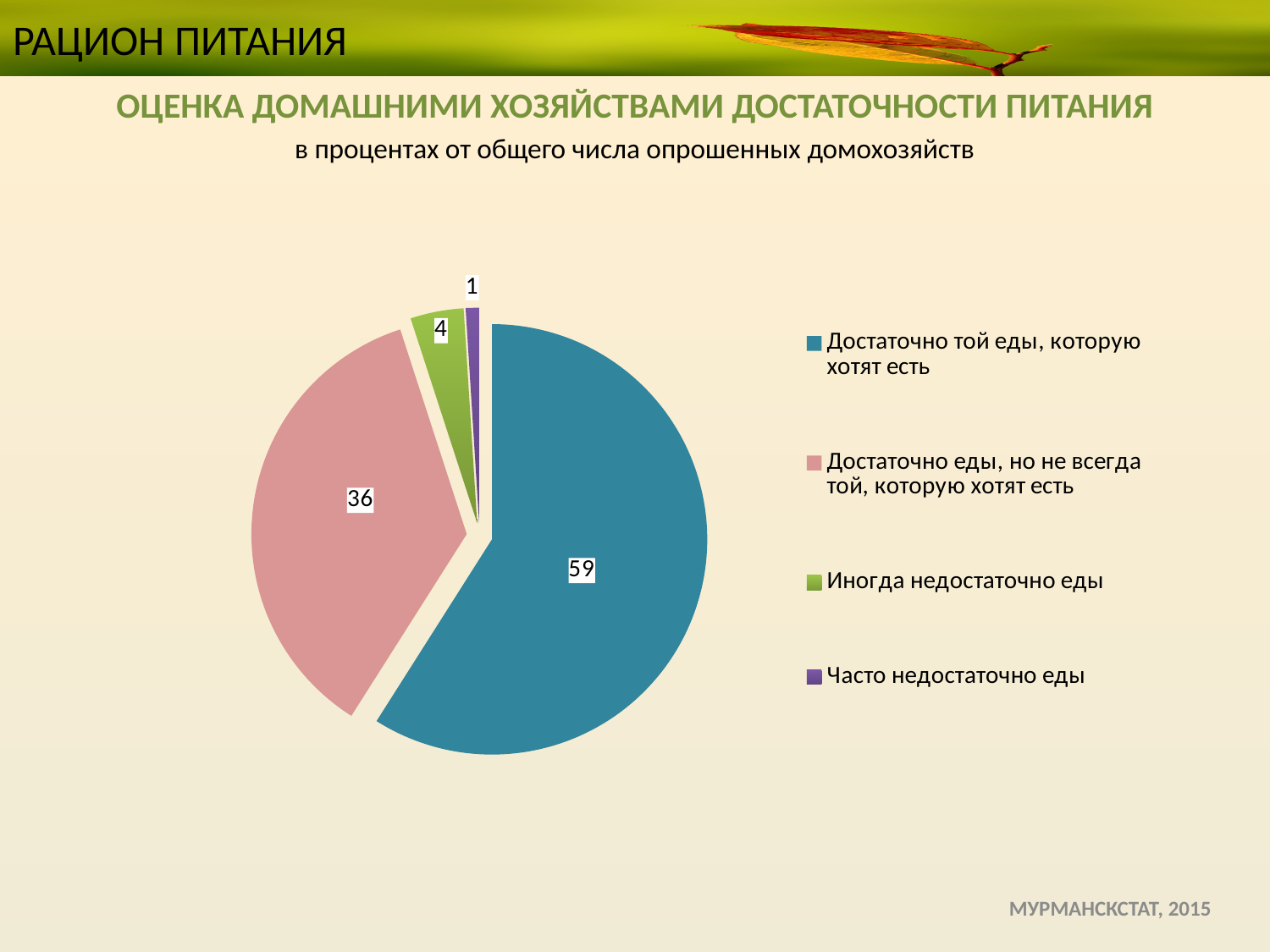
What is the value for "Достаточно еды, но не всегда той, которую хотят есть"? 36 Which category has the largest share of the pie? Достаточно той еды, которую хотят есть How many slices does the pie chart have? 4 How many entries does the legend list? 4 What is the value for "Достаточно той еды, которую хотят есть"? 59 What kind of chart is shown on the slide? pie chart What is the value for "Часто недостаточно еды"? 1 Which is larger: the value for "Иногда недостаточно еды" or the value for "Часто недостаточно еды"? Иногда недостаточно еды What is the value for "Иногда недостаточно еды"? 4 Which category has the smallest share of the pie? Часто недостаточно еды What colour is the slice for "Достаточно еды, но не всегда той, которую хотят есть"? pink What is the difference between the values for "Достаточно той еды, которую хотят есть" and "Достаточно еды, но не всегда той, которую хотят есть"? 23